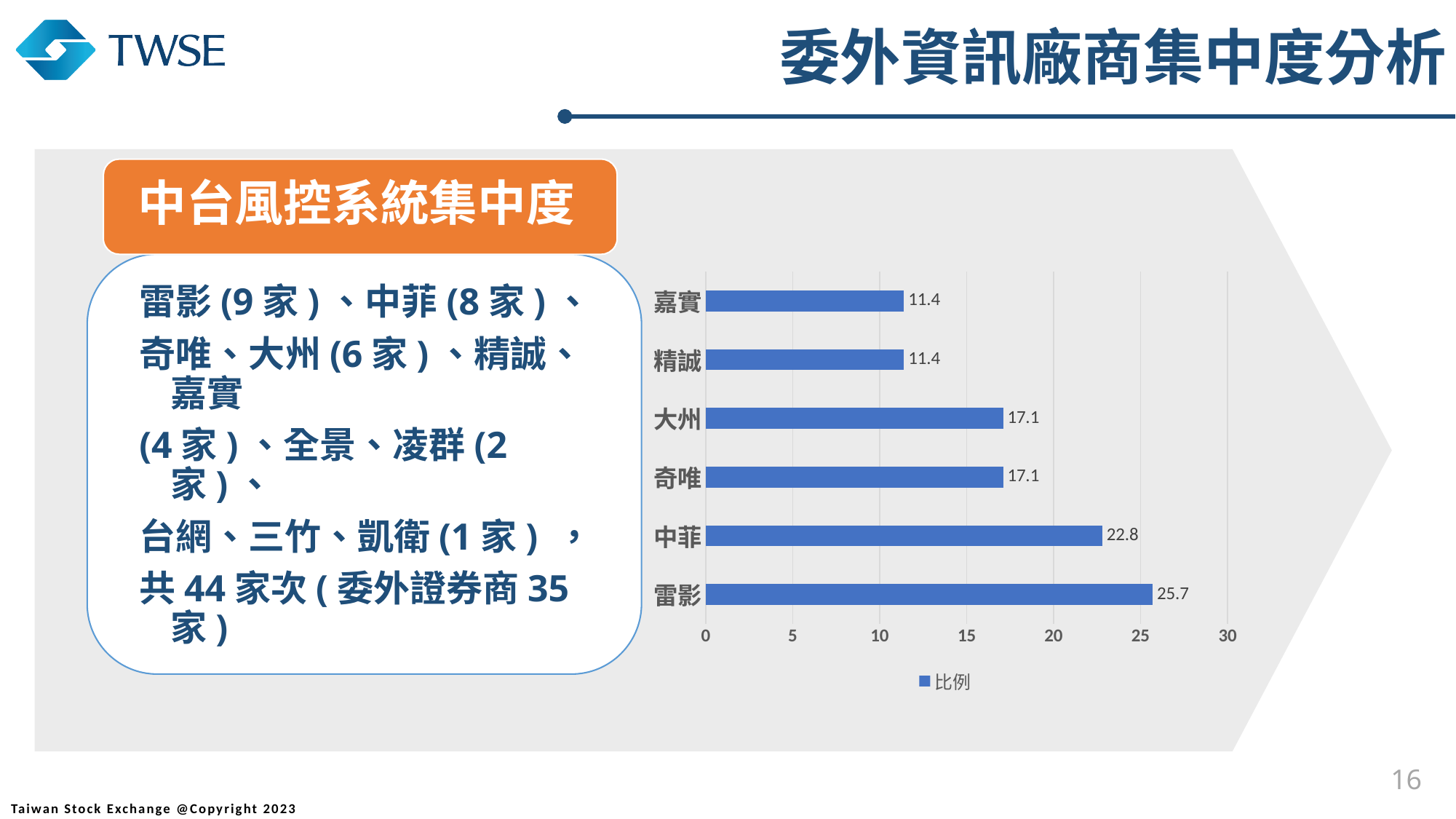
How many categories are shown in the chart? 6 What kind of chart is shown on the slide? bar chart What is the value for 中菲 in the chart? 22.8 Which category has the highest value in the chart? 雷影 What series name does the chart legend show? 比例 Which is larger, the value for 中菲 or the value for 大州? 中菲 What is the difference between the values for 雷影 and 中菲? 2.9 What is the value for 嘉實 in the chart? 11.4 What is the value for 大州 in the chart? 17.1 Is the value for 雷影 greater or less than 25? greater What is the difference between the values for 中菲 and 奇唯? 5.7 What is the value for 雷影 in the chart? 25.7